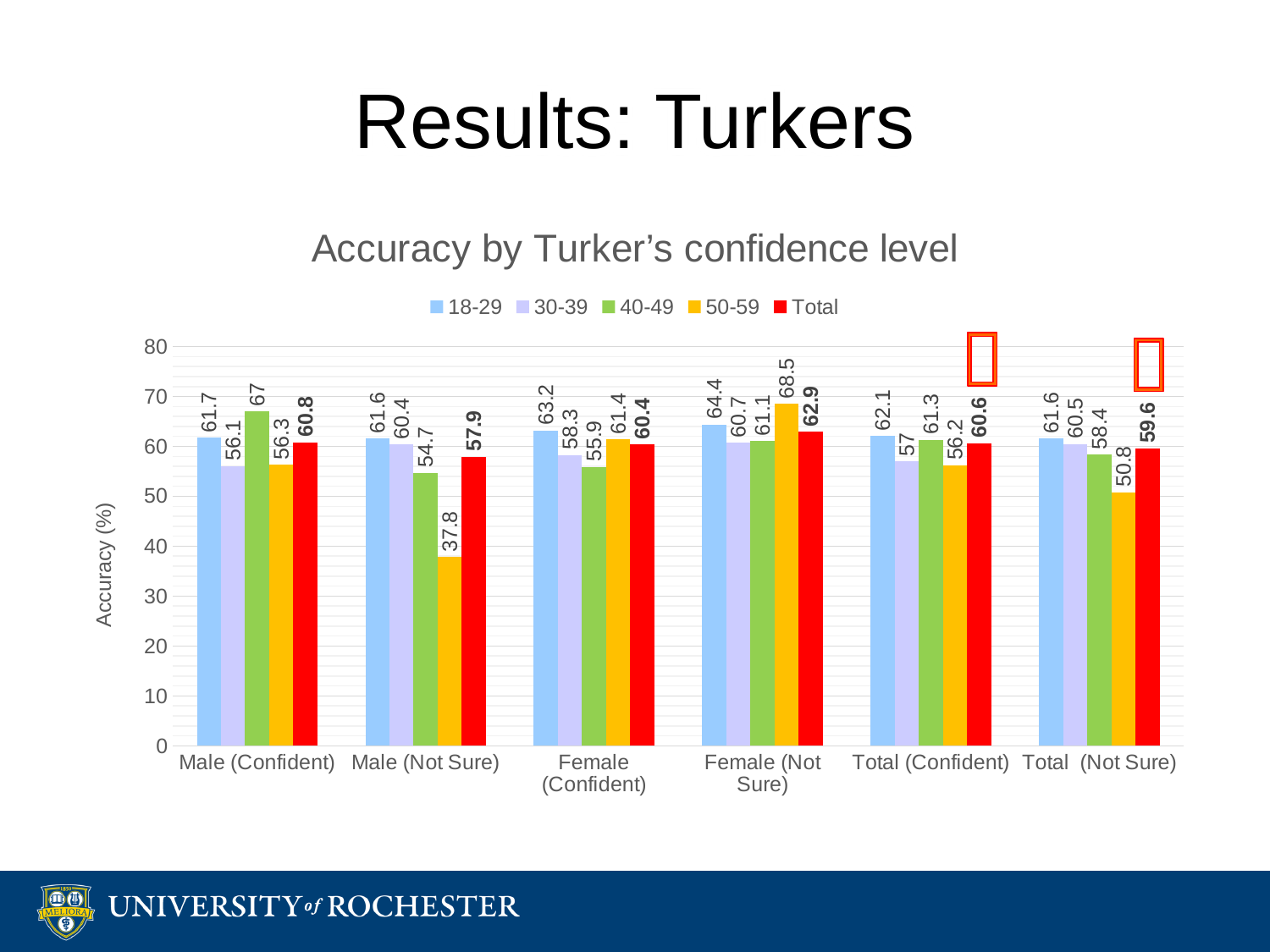
What is the Total accuracy for Female (Not Sure)? 62.9 What kind of chart is shown on the slide? Bar chart What is the accuracy for the 40-49 age group in the Male (Confident) category? 67 What is the difference between the Total accuracy for Total (Confident) and Total (Not Sure)? 1 How many series does the legend list? 5 Which category has the lowest Total accuracy? Male (Not Sure) Which is larger: the 50-59 value for Female (Not Sure) or the 50-59 value for Male (Not Sure)? Female (Not Sure) Which category has the highest Total accuracy? Female (Not Sure) How many categories are shown on the x axis? 6 Is the 50-59 value for Male (Not Sure) greater or less than 40? less What is the title of the chart? Accuracy by Turker's confidence level What is the accuracy for the 50-59 age group in the Male (Not Sure) category? 37.8